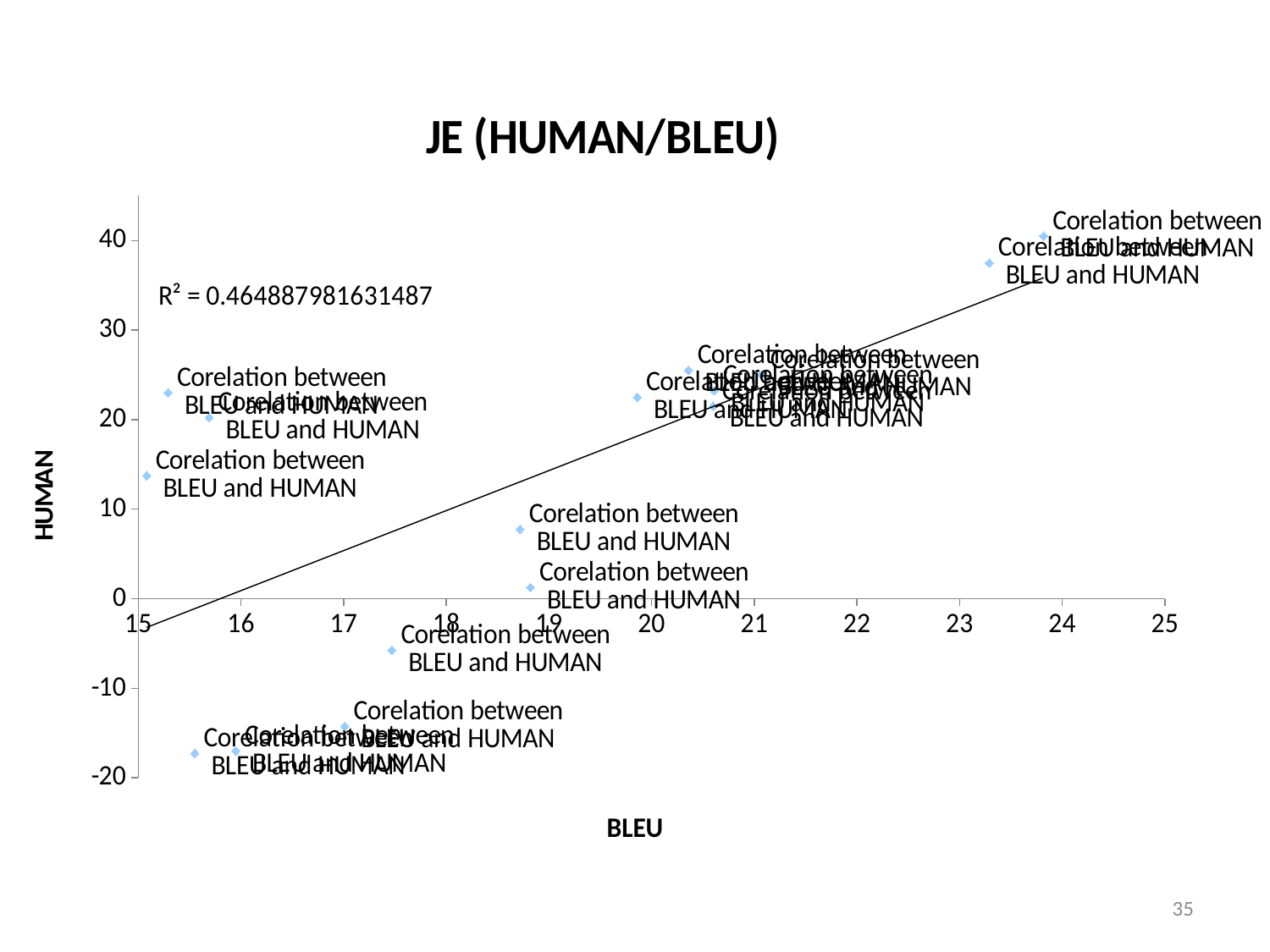
What is the label of the horizontal axis? BLEU What is the title of the chart? JE (HUMAN/BLEU) Which has the larger HUMAN value: the point at a BLEU score of about 15.3 or the point at about 18.7? the point at about 15.3 What is the highest value shown on the HUMAN axis? 40 Is the HUMAN value for the point at a BLEU score of about 17.5 greater or less than 0? less Do the HUMAN values generally rise or fall as BLEU increases along the x axis? rise Is the HUMAN value for the point with the highest BLEU score (near 24) greater or less than 30? greater Which point has the highest HUMAN value: the one at a BLEU score of about 23.3 or the one at about 23.8? the one at about 23.8 Is the HUMAN value for the point at a BLEU score of about 20.3 greater or less than 20? greater What kind of chart is shown on the slide? scatter chart What is the R² value shown on the chart? R² = 0.464887981631487